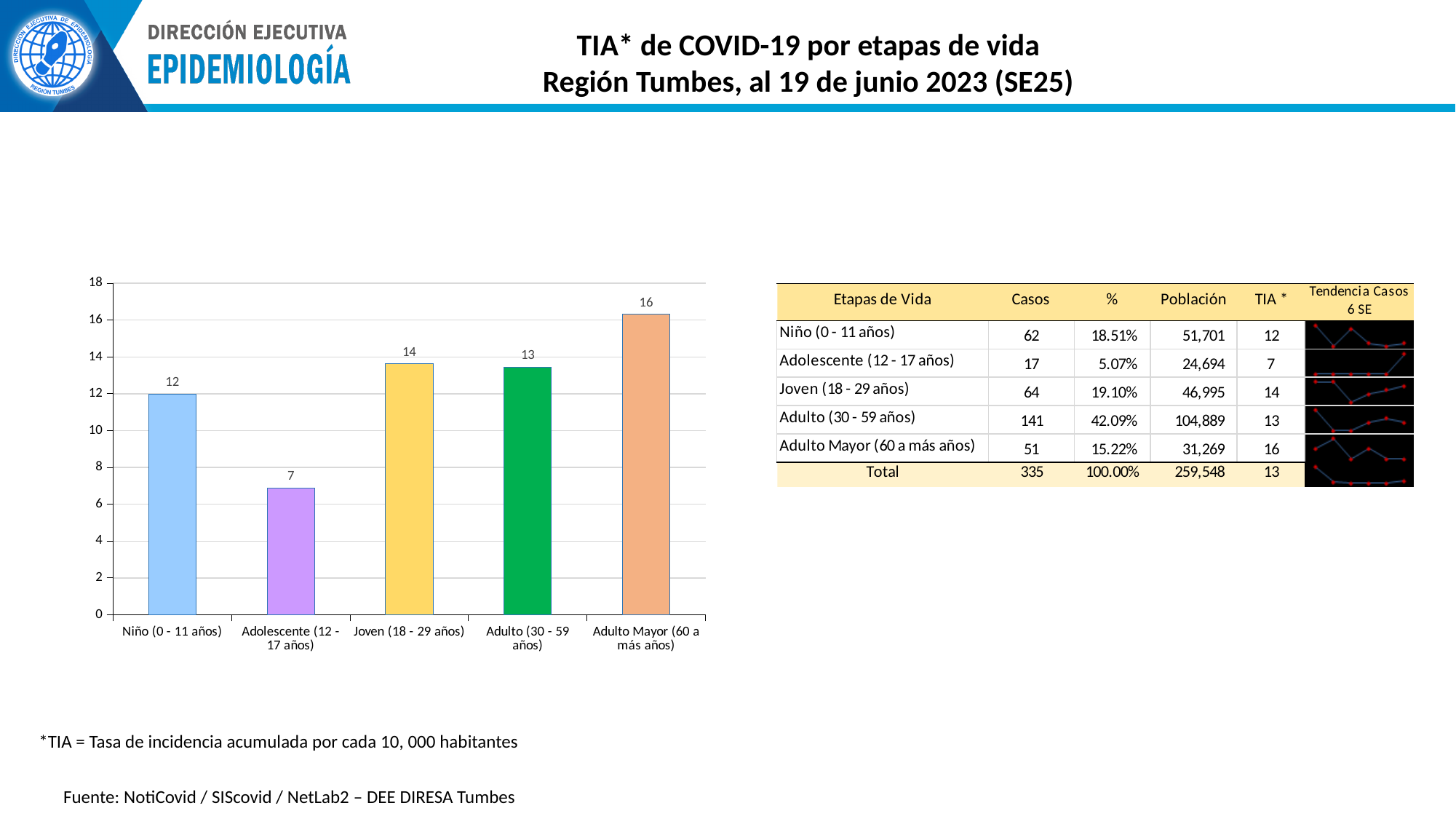
What is the difference between the TIA for Adulto Mayor (60 a más años) and Adolescente (12 - 17 años) in the bar chart? 9 What is the TIA value shown for Adolescente (12 - 17 años) in the bar chart? 7 What kind of chart is used to show TIA by life stage? Bar chart What is the maximum value shown on the vertical axis of the bar chart? 18 Which life stage has the highest TIA in the bar chart? Adulto Mayor (60 a más años) What is the TIA value shown for Niño (0 - 11 años) in the bar chart? 12 What is the TIA value shown for Joven (18 - 29 años) in the bar chart? 14 Which life stage has the lowest TIA in the bar chart? Adolescente (12 - 17 años) What is the TIA value shown for Adulto Mayor (60 a más años) in the bar chart? 16 Is the TIA value for Adulto (30 - 59 años) in the bar chart greater or less than 10? greater How many life-stage categories are shown in the bar chart? 5 Which has a higher TIA in the bar chart, Niño (0 - 11 años) or Joven (18 - 29 años)? Joven (18 - 29 años)